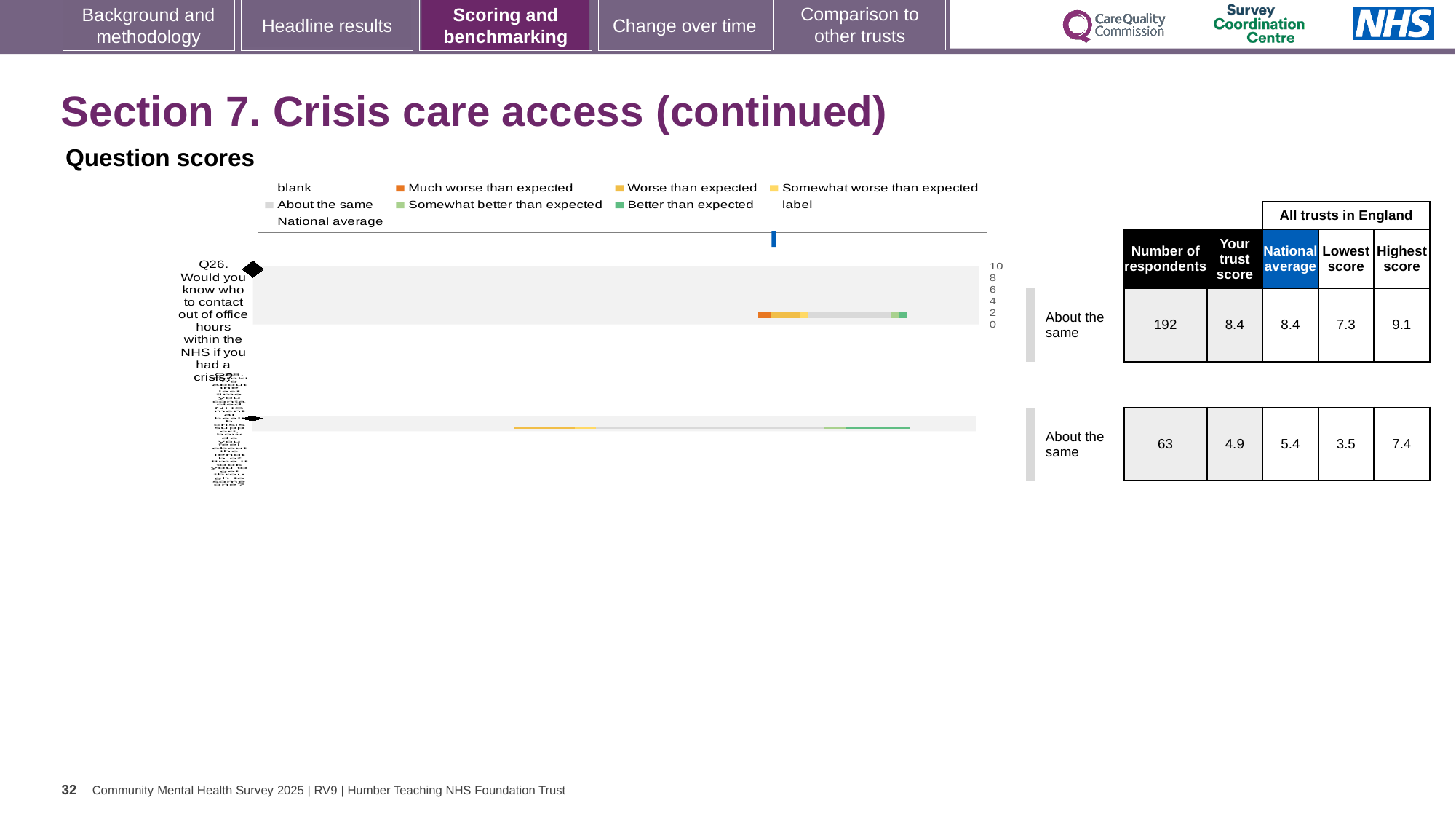
What is the lowest score among all trusts in England for Q26? 7.3 How many respondents are listed for the second question row, below Q26? 63 Is the trust score for Q26 higher than, lower than, or the same as the national average? the same What benchmark category is shown for Q26? About the same What is the highest score among all trusts in England for Q26? 9.1 What is the difference between the highest and lowest trust scores in England for Q26? 1.8 What is the trust score for Q26 (Would you know who to contact out of office hours within the NHS if you had a crisis?)? 8.4 Is the trust score for Q26 greater or less than 6 on the score axis? greater What is the national average score for Q26? 8.4 How many respondents answered Q26? 192 Which colour represents 'Much worse than expected' in the legend? orange What kind of chart is used to show the question scores? bar chart